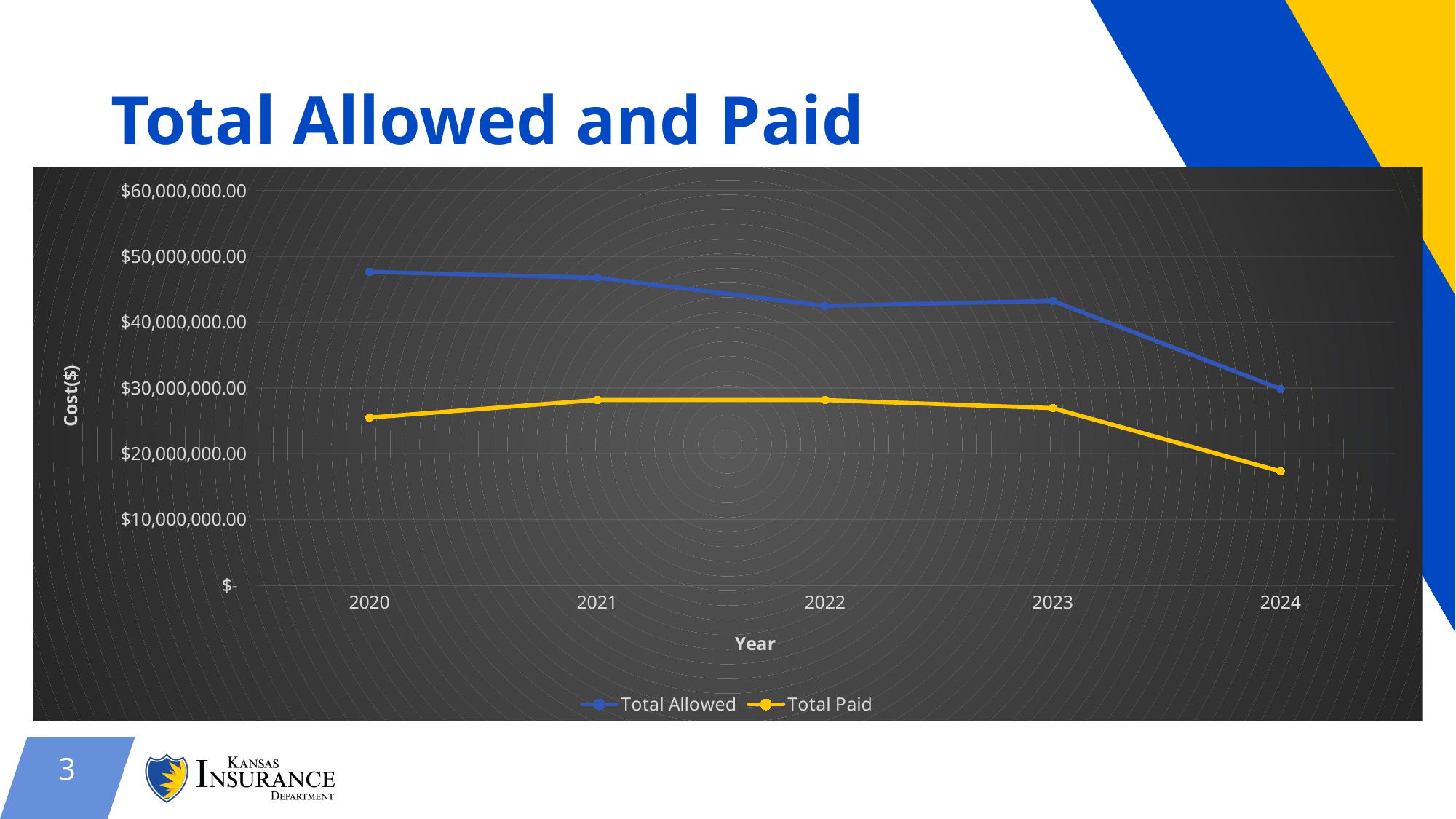
Is the Total Paid value for 2021 greater or less than $30,000,000.00? less Is the Total Paid value for 2024 greater or less than $20,000,000.00? less Does the Total Allowed series rise or fall overall from 2020 to 2024? Fall In which year is the Total Paid value lowest? 2024 How many years are plotted along the x axis? 5 Is the Total Allowed value for 2020 greater or less than $40,000,000.00? greater In 2023, which is larger: Total Allowed or Total Paid? Total Allowed In which year is the Total Allowed value lowest? 2024 How many series does the legend list? 2 What kind of chart is shown on the slide? Line chart